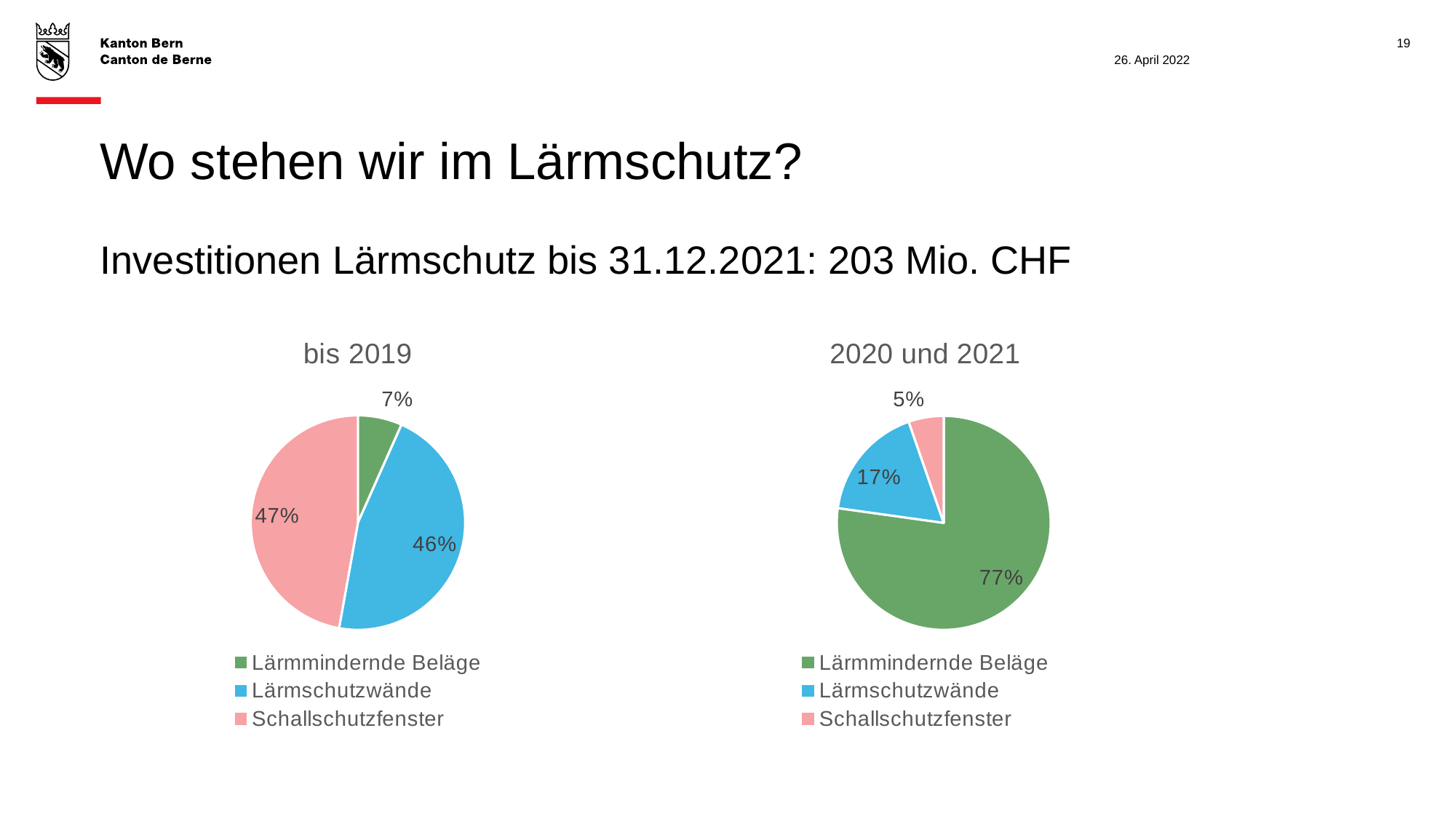
In the '2020 und 2021' chart, which category has the largest slice? Lärmmindernde Beläge What kind of chart is the 'bis 2019' chart? Pie chart In the 'bis 2019' chart, what share is Schallschutzfenster? 47% In the '2020 und 2021' chart, what share is Lärmschutzwände? 17% In the 'bis 2019' chart, what share is Lärmschutzwände? 46% How many categories does the legend of the '2020 und 2021' chart list? 3 In the 'bis 2019' chart, which is larger: Lärmschutzwände or Lärmmindernde Beläge? Lärmschutzwände In the 'bis 2019' chart, which category has the smallest slice? Lärmmindernde Beläge In the '2020 und 2021' chart, what is the difference between the Lärmmindernde Beläge share and the Lärmschutzwände share? 60%